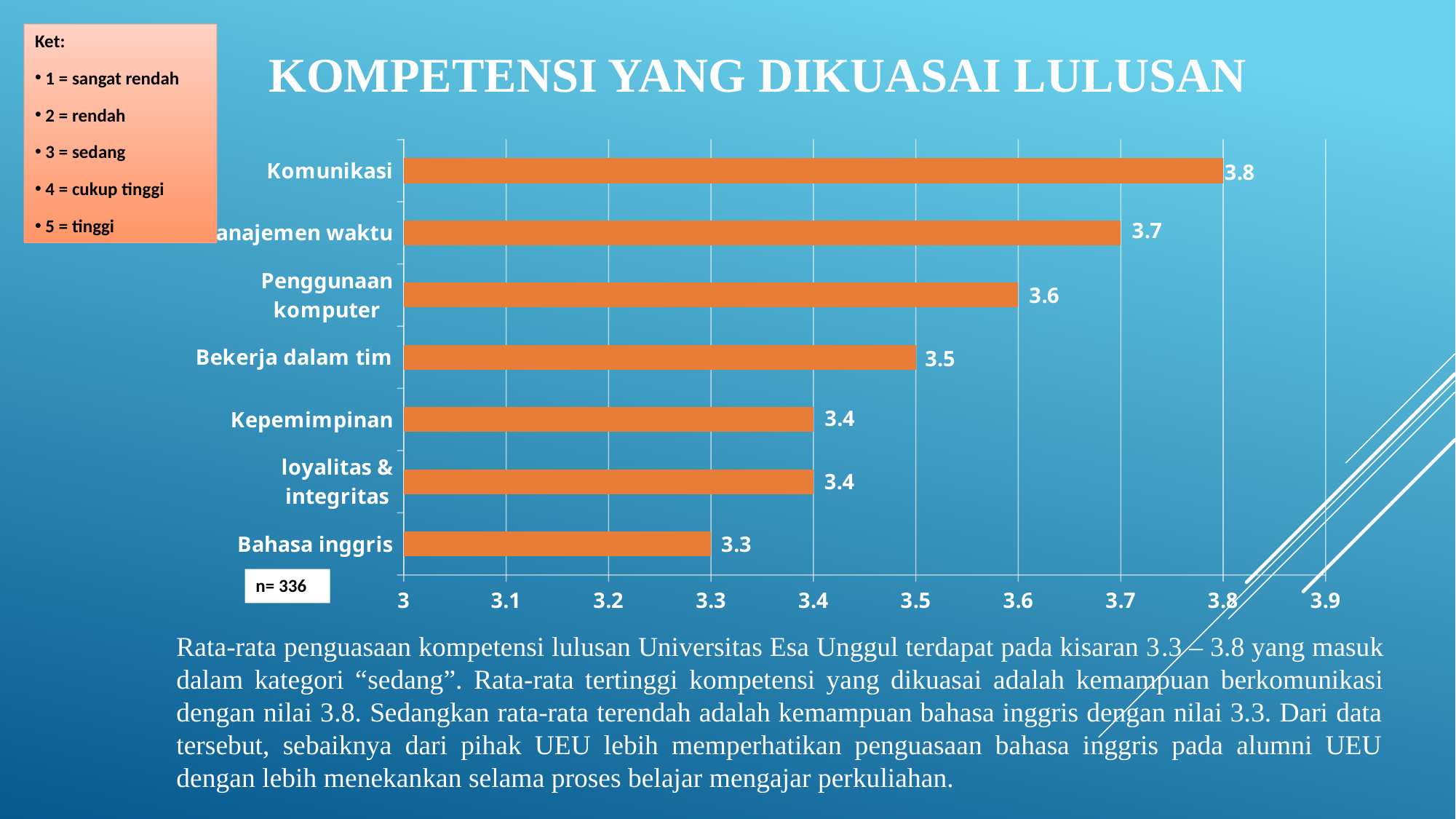
Is the value for Manajemen waktu greater or less than 3.5? greater Which is larger, the value for Bekerja dalam tim or the value for Kepemimpinan? Bekerja dalam tim What is the value for Komunikasi? 3.8 What is the difference between the values for Komunikasi and Bahasa inggris? 0.5 What is the title of the chart? KOMPETENSI YANG DIKUASAI LULUSAN What is the value for Penggunaan komputer? 3.6 What is the value for Bekerja dalam tim? 3.5 What is the value for Bahasa inggris? 3.3 Which category has the highest value? Komunikasi How many categories are shown in the chart? 7 Which category has the lowest value? Bahasa inggris What kind of chart is shown on the slide? Bar chart